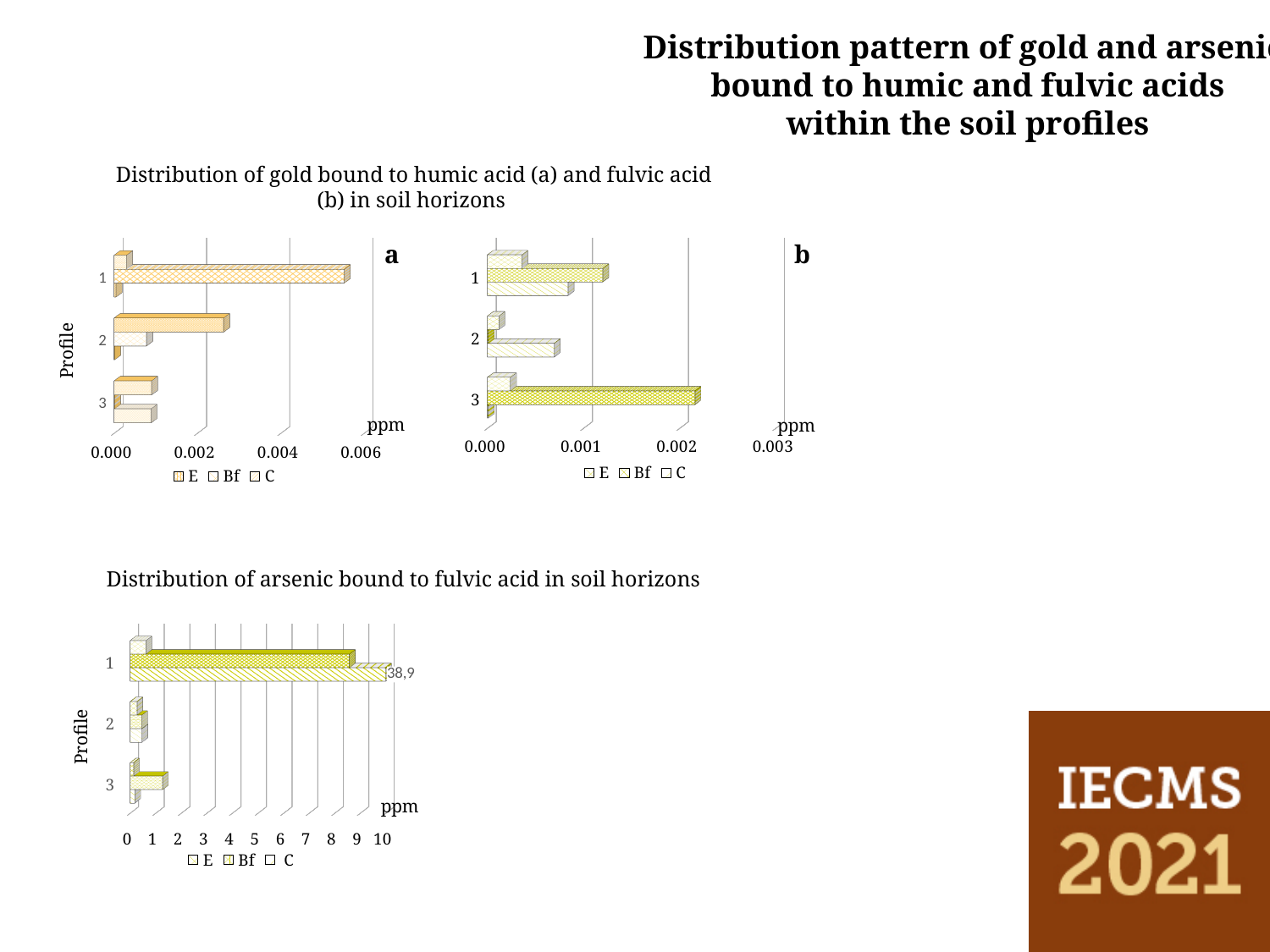
What kind of chart is chart a (gold bound to humic acid)? bar chart How many profiles are shown on the y axis of the arsenic chart? 3 In the arsenic chart, is the value for Bf in profile 1 greater or less than 5? greater In chart a, which profile has the longest bar? Profile 1 What unit is shown on the x axis of the arsenic chart? ppm How many series does the legend of chart a list? 3 In chart b, which profile has the longest bar? Profile 3 In the arsenic chart, what is the value labelled for series C in profile 1? 38,9 In chart a, is the value for Bf in profile 1 greater or less than 0.004? greater In chart b, is the value for Bf in profile 3 greater or less than 0.001? greater In the arsenic chart, which profile has the longest bar? Profile 1